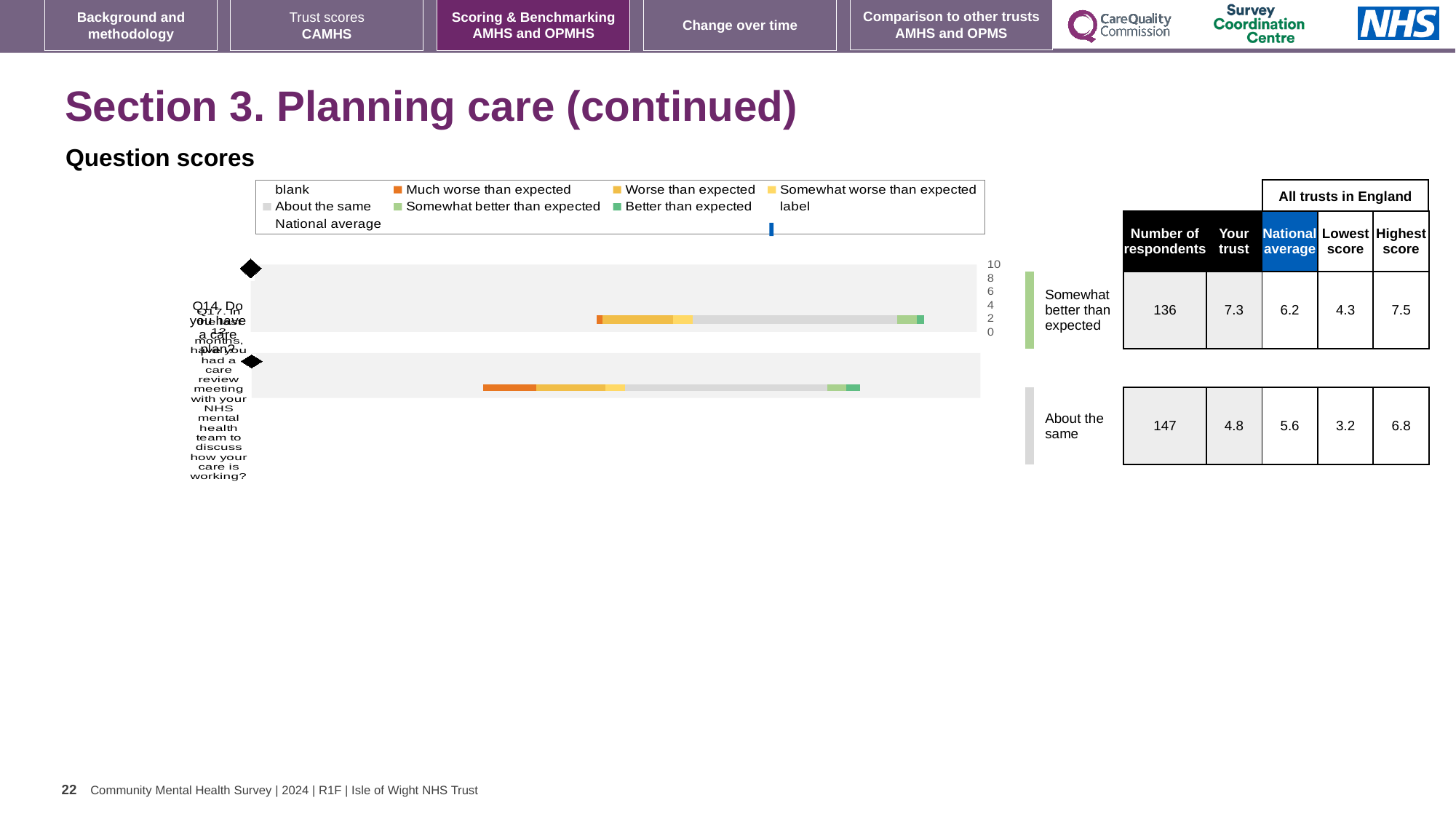
What is the 'Your trust' score for Q17 about having a care review meeting? 4.8 For Q17, which is larger: the trust's score or the national average? National average How much lower is the trust's score than the national average for Q17? 0.8 Which of the two questions has the higher 'Your trust' score? Q14 What benchmark category is the trust's Q14 score placed in? Somewhat better than expected What is the 'Your trust' score for Q14 'Do you have a care plan?'? 7.3 What is the lowest score across all trusts in England for Q17? 3.2 What is the national average score for Q14 'Do you have a care plan?'? 6.2 What is the difference between the highest and lowest scores for Q14? 3.2 How many questions are plotted in the chart? 2 How many respondents answered Q17 about having a care review meeting in the last 12 months? 147 For Q14, is the trust's score higher or lower than the national average? Higher